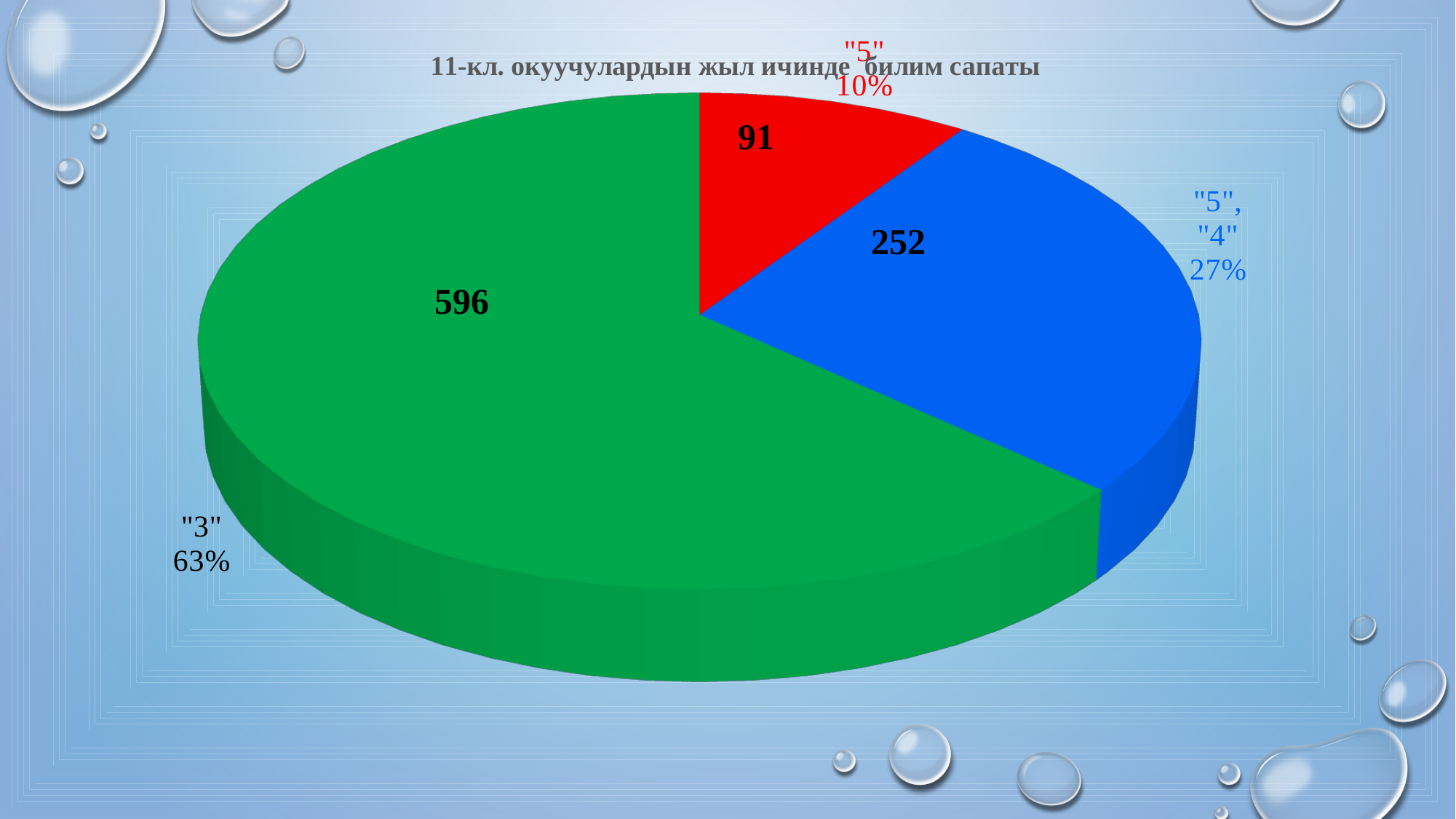
What kind of chart is shown on the slide? pie chart What share of the pie does the "5" slice represent? 10% What is the value of the "5" slice? 91 What is the value of the "5", "4" slice? 252 What is the difference between the "3" slice and the "5", "4" slice? 344 What colour is the "5" slice? red Which slice is the largest? "3" Which slice is the smallest? "5" How many slices does the pie chart have? 3 What is the title of the chart? 11-кл. окуучулардын жыл ичинде билим сапаты What is the value of the "3" slice? 596 What share of the pie does the "3" slice represent? 63%